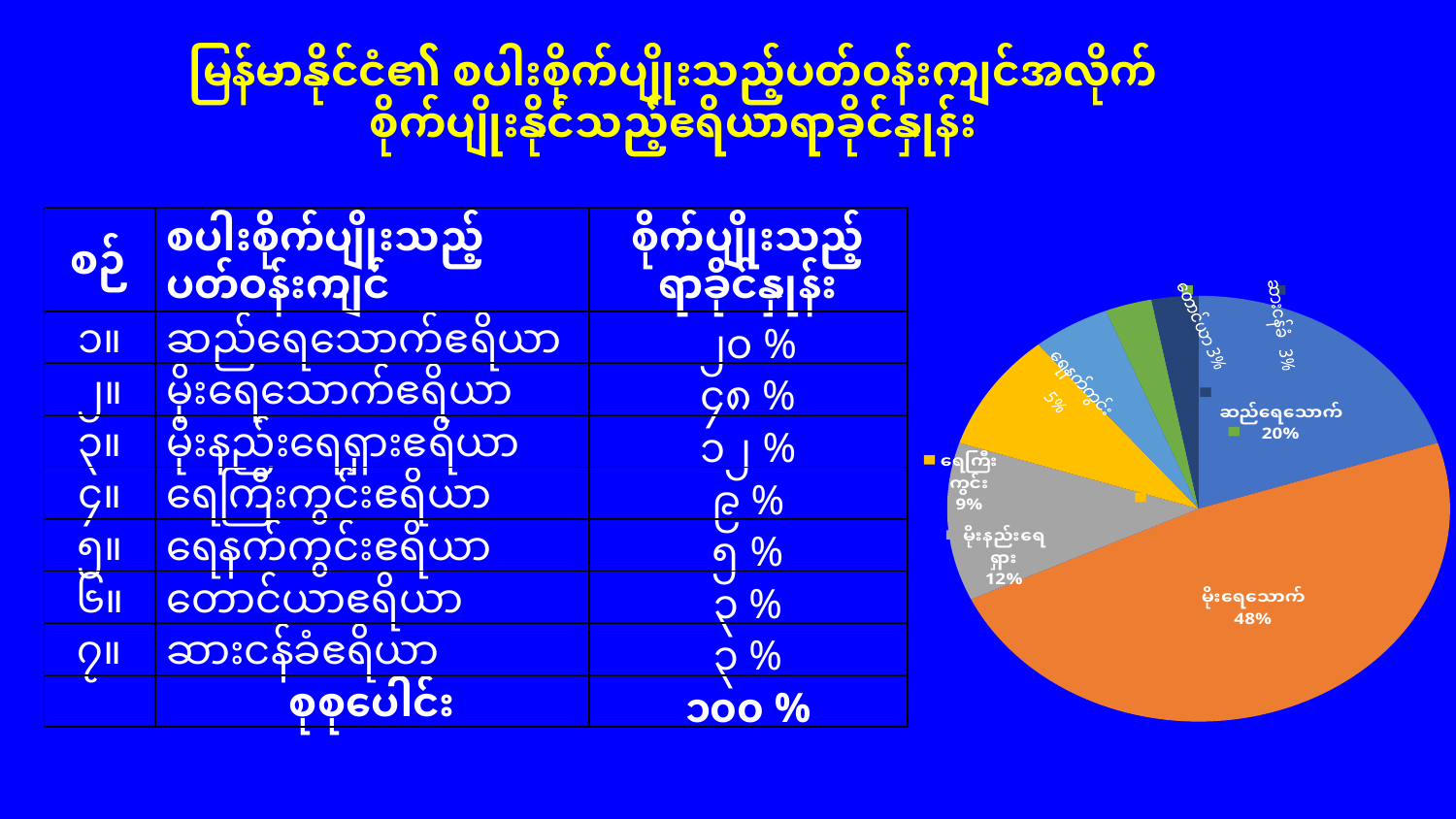
In the pie chart, which is larger: ဆည်ရေသောက် or မိုးနည်းရေရှား? ဆည်ရေသောက် What colour is the largest slice (မိုးရေသောက်) in the pie chart? orange In the pie chart, what share is shown for မိုးရေသောက်? 48% In the pie chart, what is the difference between the shares of မိုးရေသောက် and ဆည်ရေသောက်? 28% In the pie chart, what share is shown for ရေကြီးကွင်း? 9% In the pie chart, what is the difference between the shares of ရေကြီးကွင်း and ရေနက်ကွင်း? 4% In the pie chart, what share is shown for ဆည်ရေသောက်? 20% How many slices does the pie chart have? 7 Which category has the largest slice in the pie chart? မိုးရေသောက် In the pie chart, what share is shown for ရေနက်ကွင်း? 5% What kind of chart is shown on the right of the slide? pie chart In the pie chart, what share is shown for မိုးနည်းရေရှား? 12%